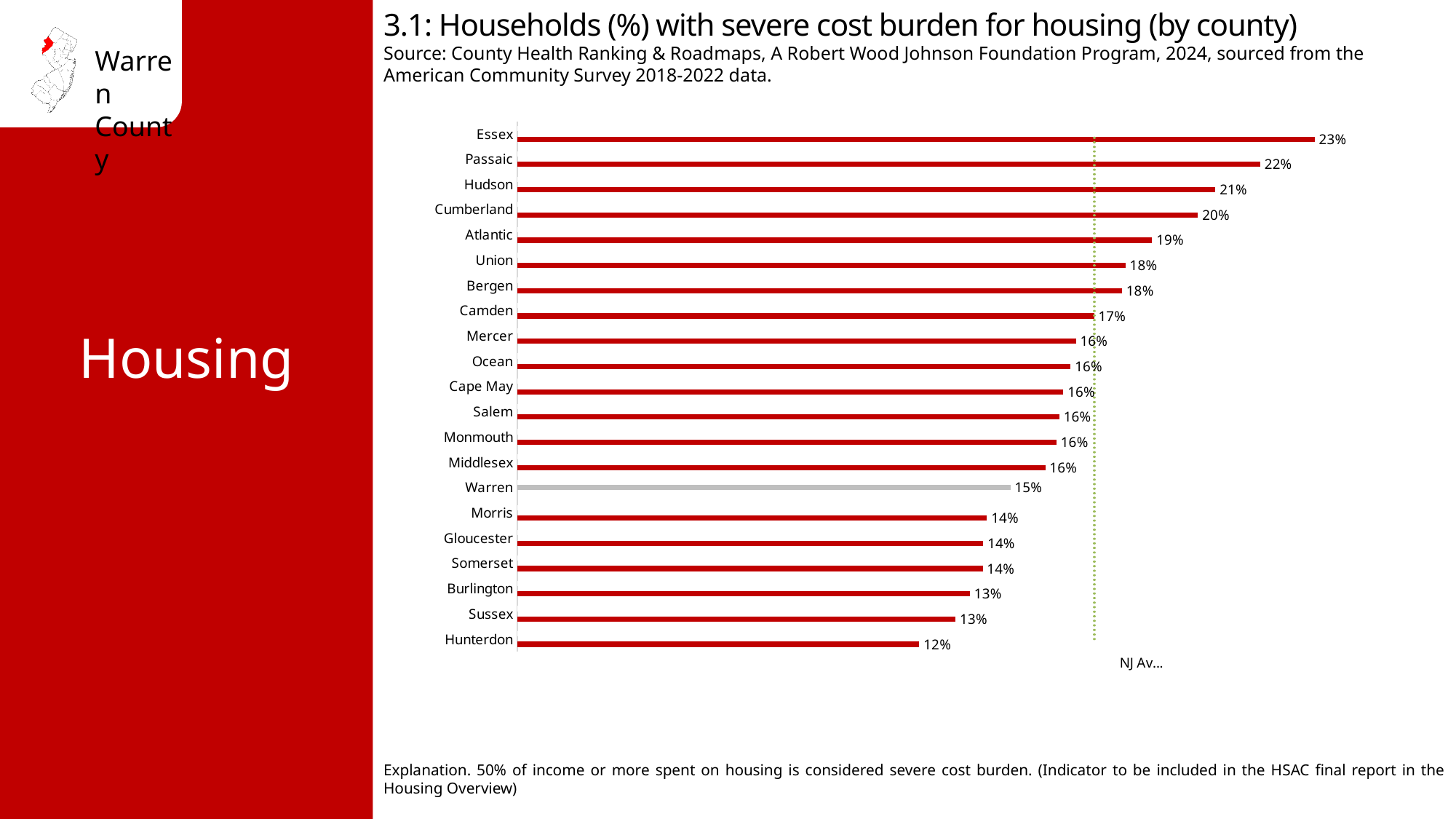
What is the value for Hunterdon? 12% What is the value for Warren? 15% What kind of chart is this? Bar chart What is the value for Essex? 23% Which has a larger value, Passaic or Atlantic? Passaic What is the difference between the values for Hudson and Hunterdon? 9% How many counties are shown in the chart? 21 What is the difference between the values for Essex and Warren? 8% Which county has the lowest value? Hunterdon Which county has the highest value? Essex What is the value for Cumberland? 20% Which county's bar is shown in grey rather than red? Warren